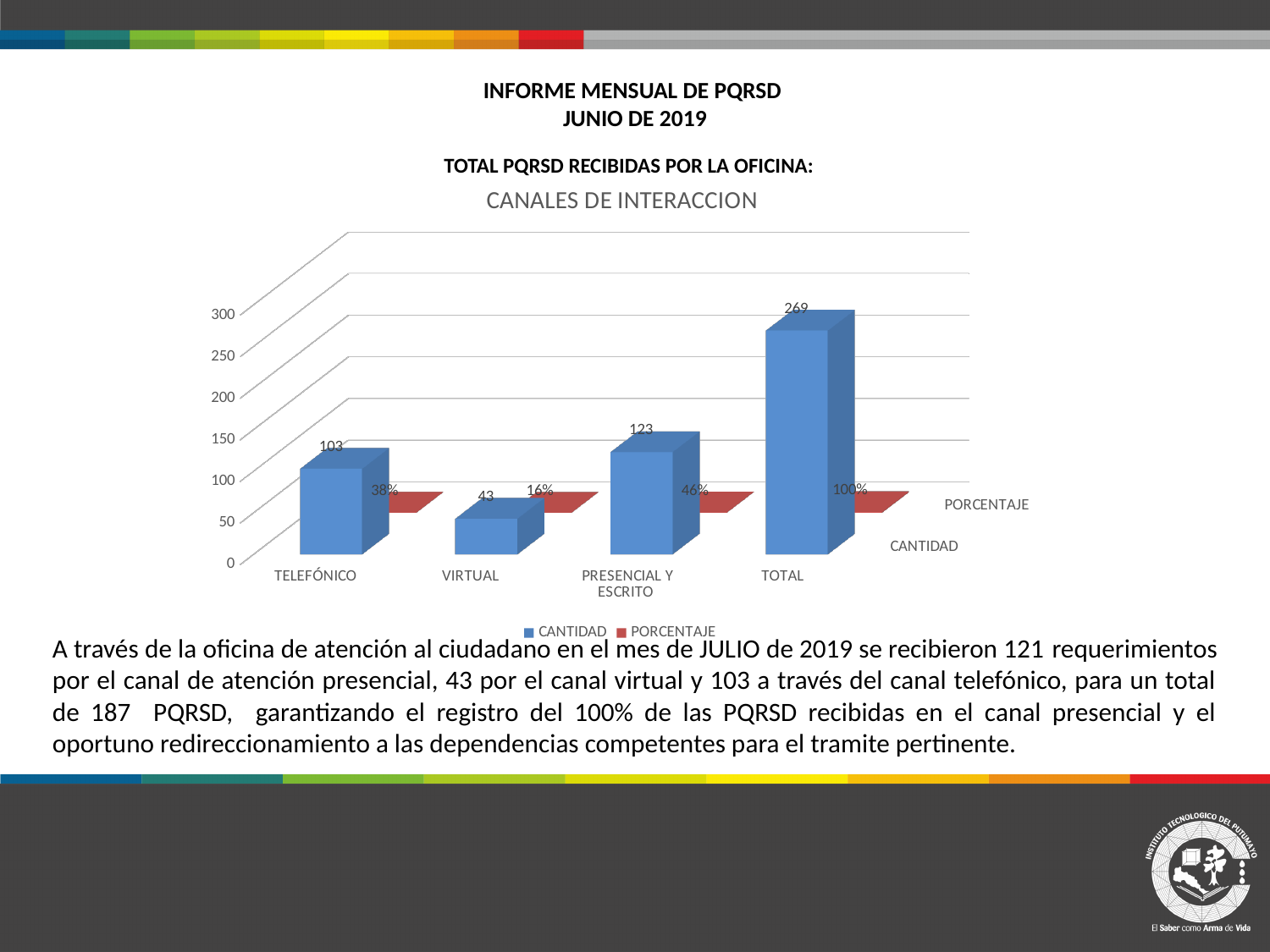
Which category has the lowest CANTIDAD value in the CANALES DE INTERACCION chart? VIRTUAL What is the CANTIDAD value for PRESENCIAL Y ESCRITO in the CANALES DE INTERACCION chart? 123 Which has a larger CANTIDAD value in the CANALES DE INTERACCION chart, TELEFÓNICO or VIRTUAL? TELEFÓNICO What kind of chart is the CANALES DE INTERACCION chart? Bar chart How many categories are shown on the x axis of the CANALES DE INTERACCION chart? 4 Which category has the highest CANTIDAD value in the CANALES DE INTERACCION chart? TOTAL How many series does the legend of the CANALES DE INTERACCION chart list? 2 What PORCENTAJE is shown for PRESENCIAL Y ESCRITO in the CANALES DE INTERACCION chart? 46% What is the CANTIDAD value for VIRTUAL in the CANALES DE INTERACCION chart? 43 What is the difference between the CANTIDAD values for PRESENCIAL Y ESCRITO and TELEFÓNICO in the CANALES DE INTERACCION chart? 20 What PORCENTAJE is shown for VIRTUAL in the CANALES DE INTERACCION chart? 16% What is the CANTIDAD value for TELEFÓNICO in the CANALES DE INTERACCION chart? 103